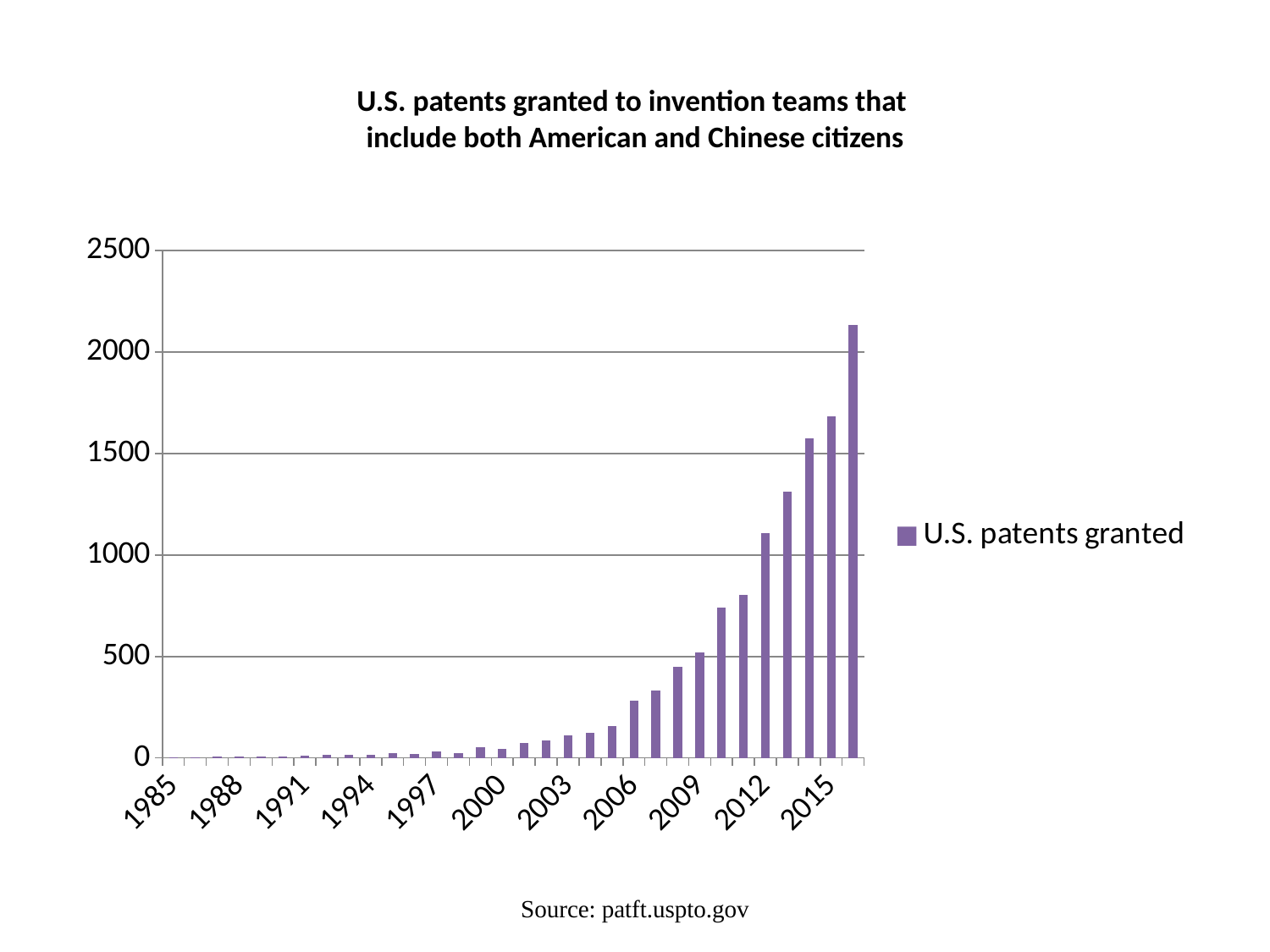
What kind of chart is shown on the slide? Bar chart Do the values generally rise or fall from 1985 to the right end of the x axis? Rise What is the title of the chart? U.S. patents granted to invention teams that include both American and Chinese citizens Is the value for the rightmost bar greater or less than 2000? greater Which is larger, the value for 2012 or the value for 2009? 2012 Is the value for 2006 greater or less than 500? less Is the value for 2015 greater or less than 1500? greater How many series does the legend list? 1 What is the legend entry for the series shown? U.S. patents granted Which labeled year on the x axis has the lowest value, 1985 or 2015? 1985